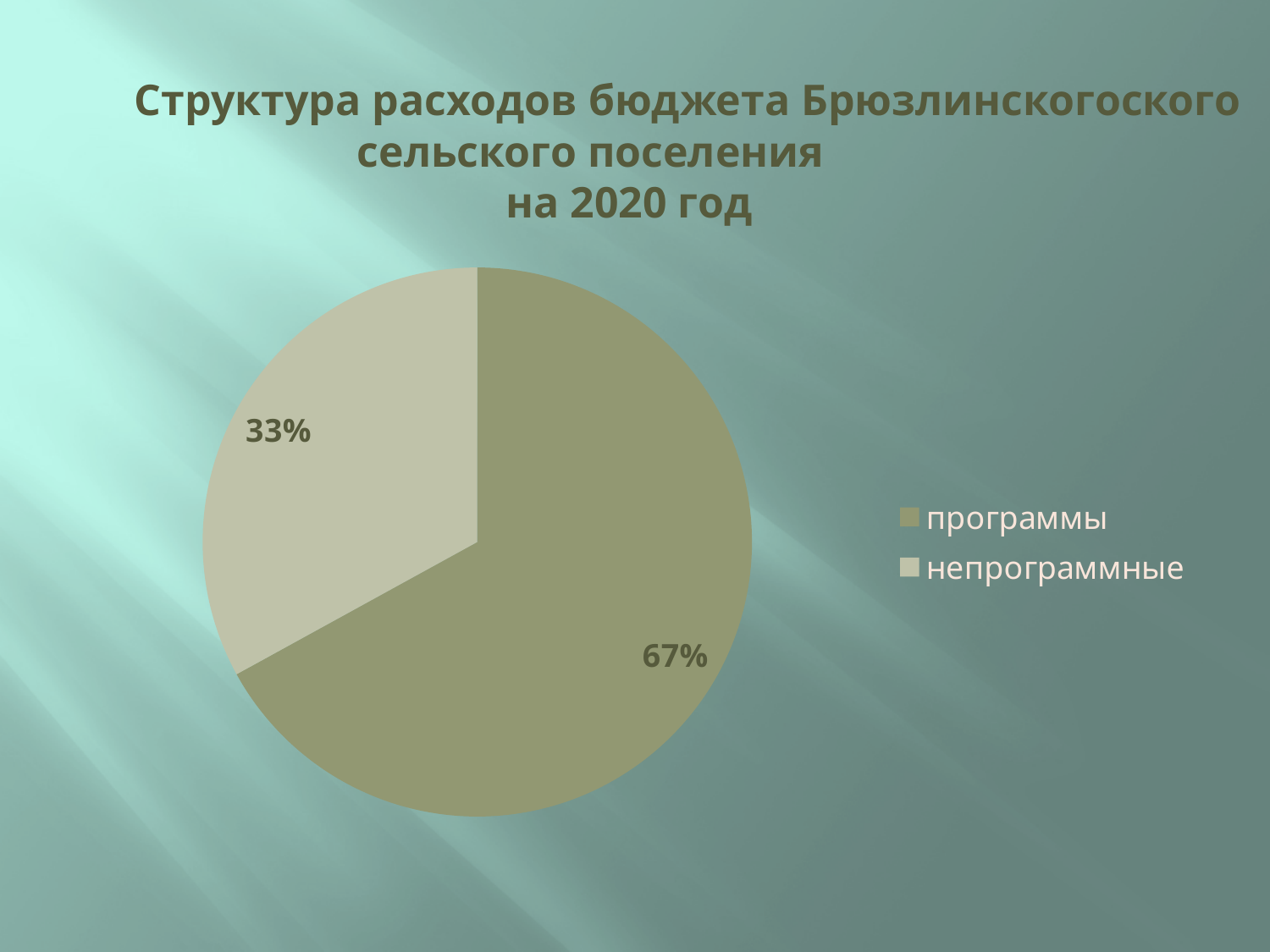
How many slices does the pie chart have? 2 What is the difference in percentage points between the "программы" and "непрограммные" slices? 34 Which year does the chart title refer to? 2020 Which is larger, the "программы" slice or the "непрограммные" slice? программы Is the share for "программы" greater or less than 50%? greater Which legend entry is shown in the lighter colour? непрограммные Which category has the smallest slice of the pie? непрограммные How many entries does the legend list? 2 What share of the pie does the "непрограммные" slice take? 33% Which category has the largest slice of the pie? программы What kind of chart is shown on the slide? pie chart What share of the pie does the "программы" slice take? 67%